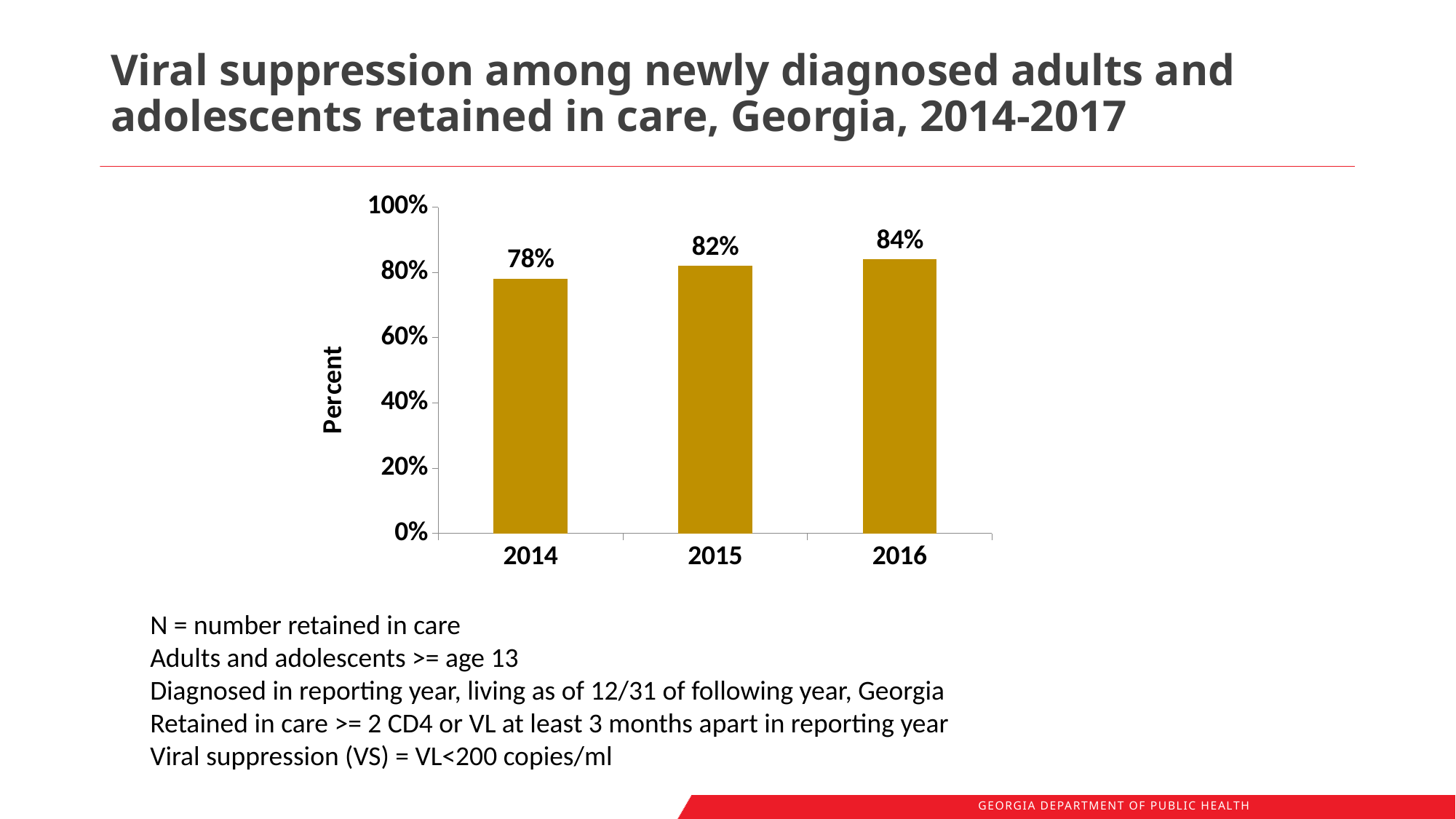
What is the viral suppression percentage for 2015? 82% What is the difference in viral suppression percentage between 2015 and 2014? 4% Is the value for 2014 greater or less than 80%? less How many years are shown on the x axis of the chart? 3 What is the difference in viral suppression percentage between 2016 and 2014? 6% What kind of chart is shown on the slide? Bar chart What is the viral suppression percentage for 2016? 84% Do the viral suppression percentages rise or fall from 2014 to 2016? Rise What is the viral suppression percentage for 2014? 78% Which year has the highest viral suppression percentage? 2016 Which year has the lowest viral suppression percentage? 2014 Which year has a higher viral suppression percentage, 2015 or 2016? 2016